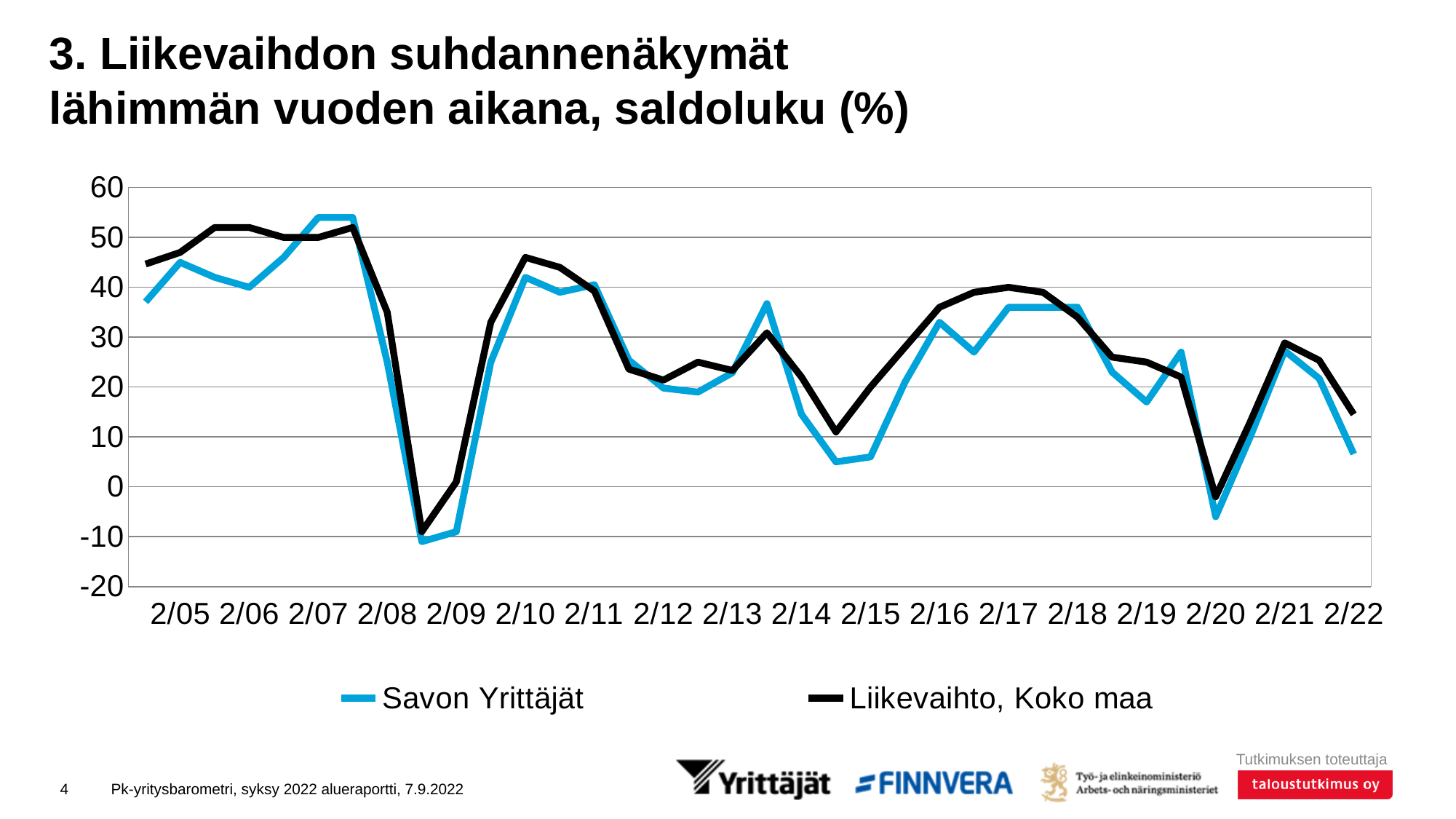
At 2/22, which series has the higher value, Savon Yrittäjät or Liikevaihto, Koko maa? Liikevaihto, Koko maa Is the value for Savon Yrittäjät at 2/07 greater or less than 50? greater Which colour is used for the Savon Yrittäjät line? blue Is the value for Savon Yrittäjät at 2/22 greater or less than 10? less Is the value for Savon Yrittäjät at 2/14 greater or less than 10? greater At 2/07, which series has the higher value, Savon Yrittäjät or Liikevaihto, Koko maa? Savon Yrittäjät How many series does the legend list? 2 Do the values for both series rise or fall from 2/21 to 2/22? fall How many year labels are shown on the x axis? 18 What kind of chart is shown on the slide? line chart